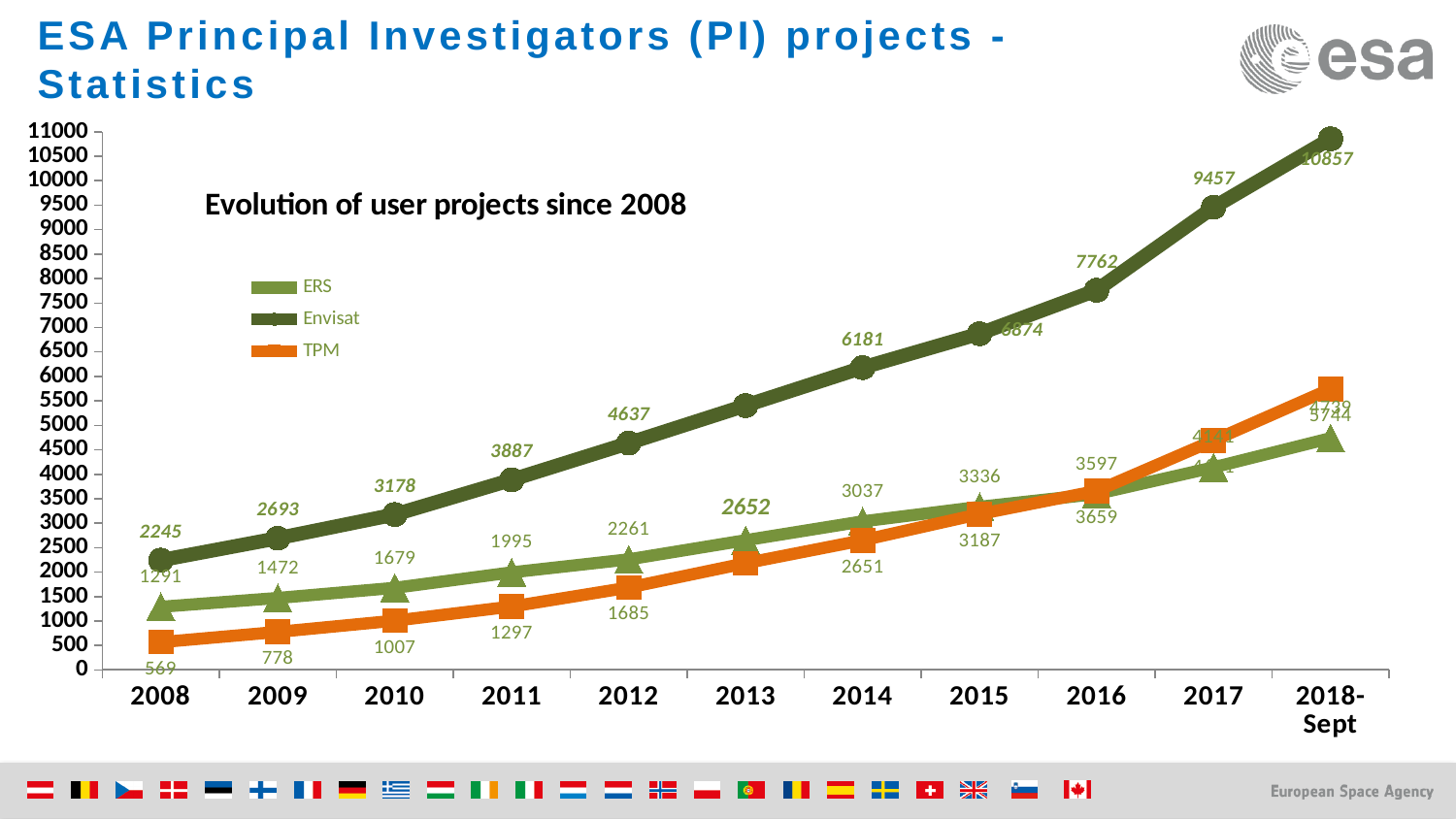
What is the difference between the Envisat values for 2017 and 2016? 1695 Does the Envisat series rise or fall from 2008 to 2018-Sept? rise Which is larger in 2014, the ERS value or the TPM value? ERS What type of chart is shown on the slide? line chart How many series does the legend list? 3 What is the ERS value for 2012? 2261 What is the Envisat value for 2018-Sept? 10857 Which series has the lowest value in 2008? TPM What is the Envisat value for 2016? 7762 What is the TPM value for 2008? 569 Which series has the highest value in 2018-Sept? Envisat How many time periods are shown on the x axis? 11